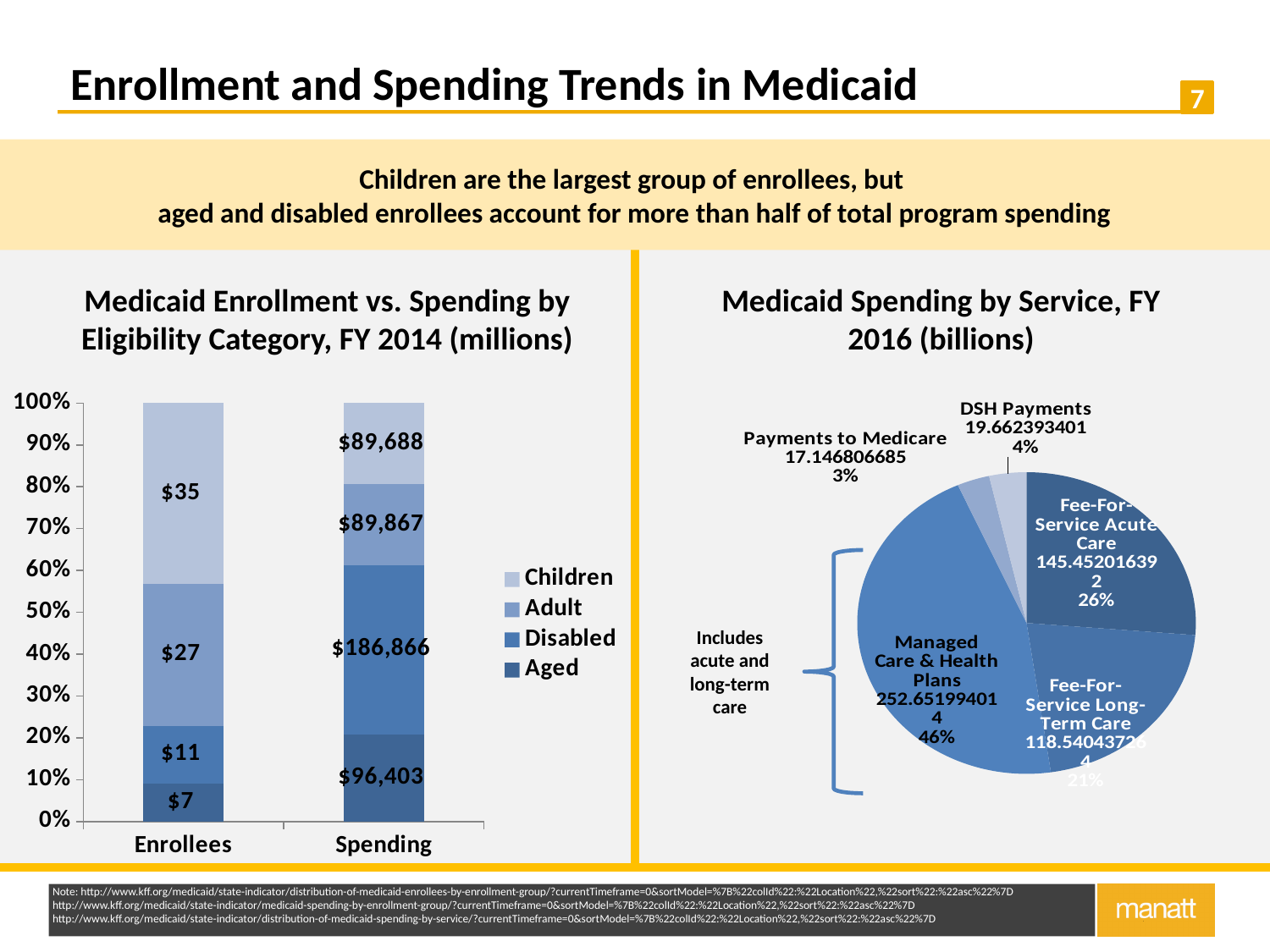
In the 'Medicaid Enrollment vs. Spending by Eligibility Category' chart, what is the value for Children in the Enrollees bar? $35 In the 'Medicaid Enrollment vs. Spending by Eligibility Category' chart, which eligibility group has the highest spending? Disabled In the 'Medicaid Enrollment vs. Spending by Eligibility Category' chart, what is the difference between the Children and Aged values in the Enrollees bar? $28 How many series does the legend of the 'Medicaid Enrollment vs. Spending by Eligibility Category' chart list? 4 In the 'Medicaid Enrollment vs. Spending by Eligibility Category' chart, what is the value for Disabled in the Spending bar? $186,866 In the 'Medicaid Spending by Service, FY 2016 (billions)' chart, which is larger: Fee-For-Service Acute Care or Fee-For-Service Long-Term Care? Fee-For-Service Acute Care What kind of chart is the 'Medicaid Spending by Service, FY 2016 (billions)' chart? Pie chart In the 'Medicaid Enrollment vs. Spending by Eligibility Category' chart, what is the value for Aged in the Spending bar? $96,403 In the 'Medicaid Spending by Service, FY 2016 (billions)' chart, which service has the smallest slice? Payments to Medicare What kind of chart is the 'Medicaid Enrollment vs. Spending by Eligibility Category, FY 2014 (millions)' chart? Stacked bar chart In the 'Medicaid Enrollment vs. Spending by Eligibility Category' chart, which eligibility group has the fewest enrollees? Aged In the 'Medicaid Spending by Service, FY 2016 (billions)' chart, what share of spending is Managed Care & Health Plans? 46%